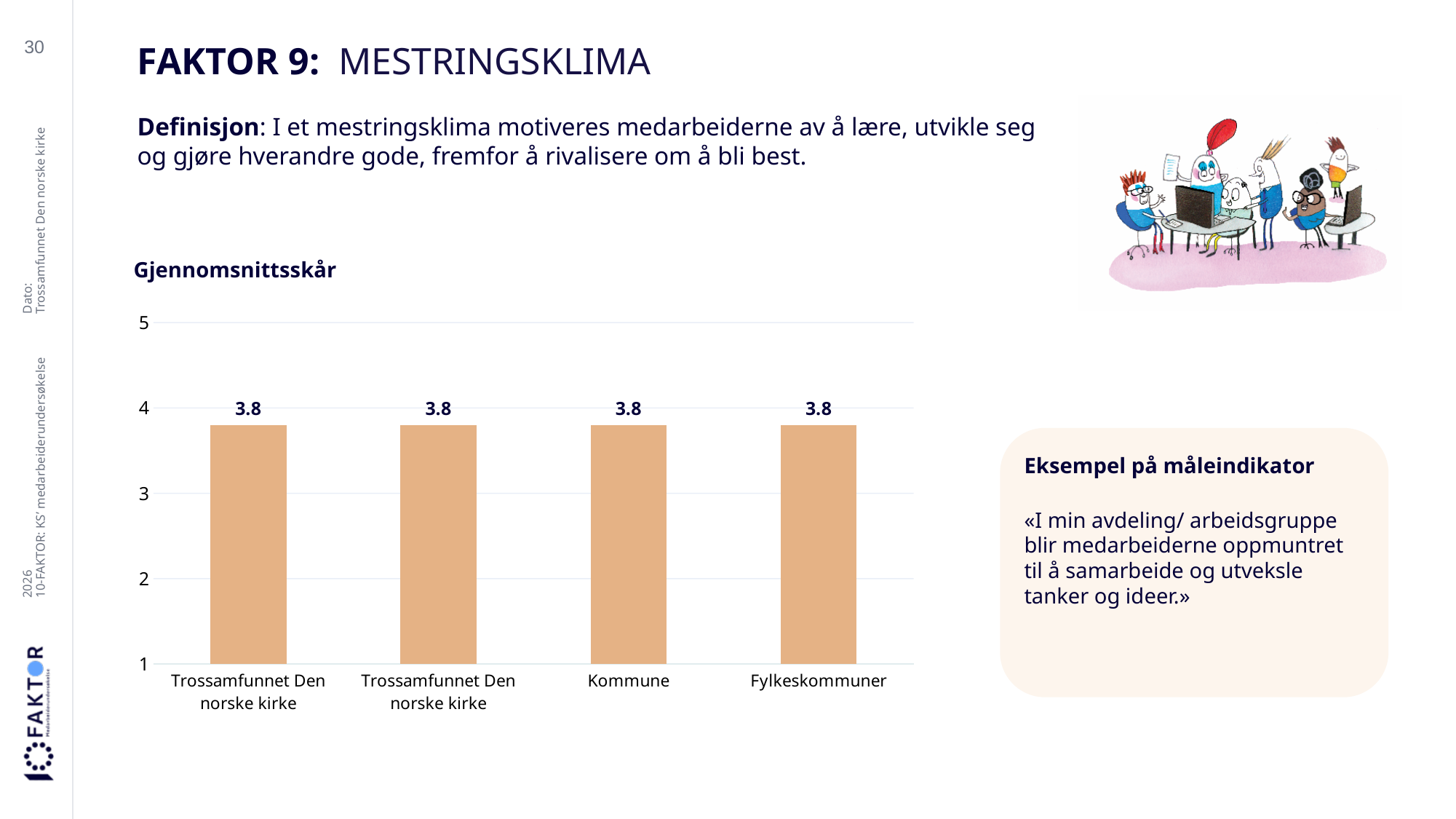
What is the title of the chart? Gjennomsnittsskår How many bars are plotted in the chart? 4 What is the difference between the values for Kommune and Fylkeskommuner? 0 What is the value for Kommune? 3.8 What is the value shown for the first bar, Trossamfunnet Den norske kirke? 3.8 What is the value for Fylkeskommuner? 3.8 Is the value for Fylkeskommuner greater or less than 4? less What is the highest value shown on the vertical axis of the chart? 5 What kind of chart is shown on the slide? Bar chart Is the value for Kommune greater or less than 3? greater Do the values rise, fall or stay the same across the categories from left to right? Stay the same